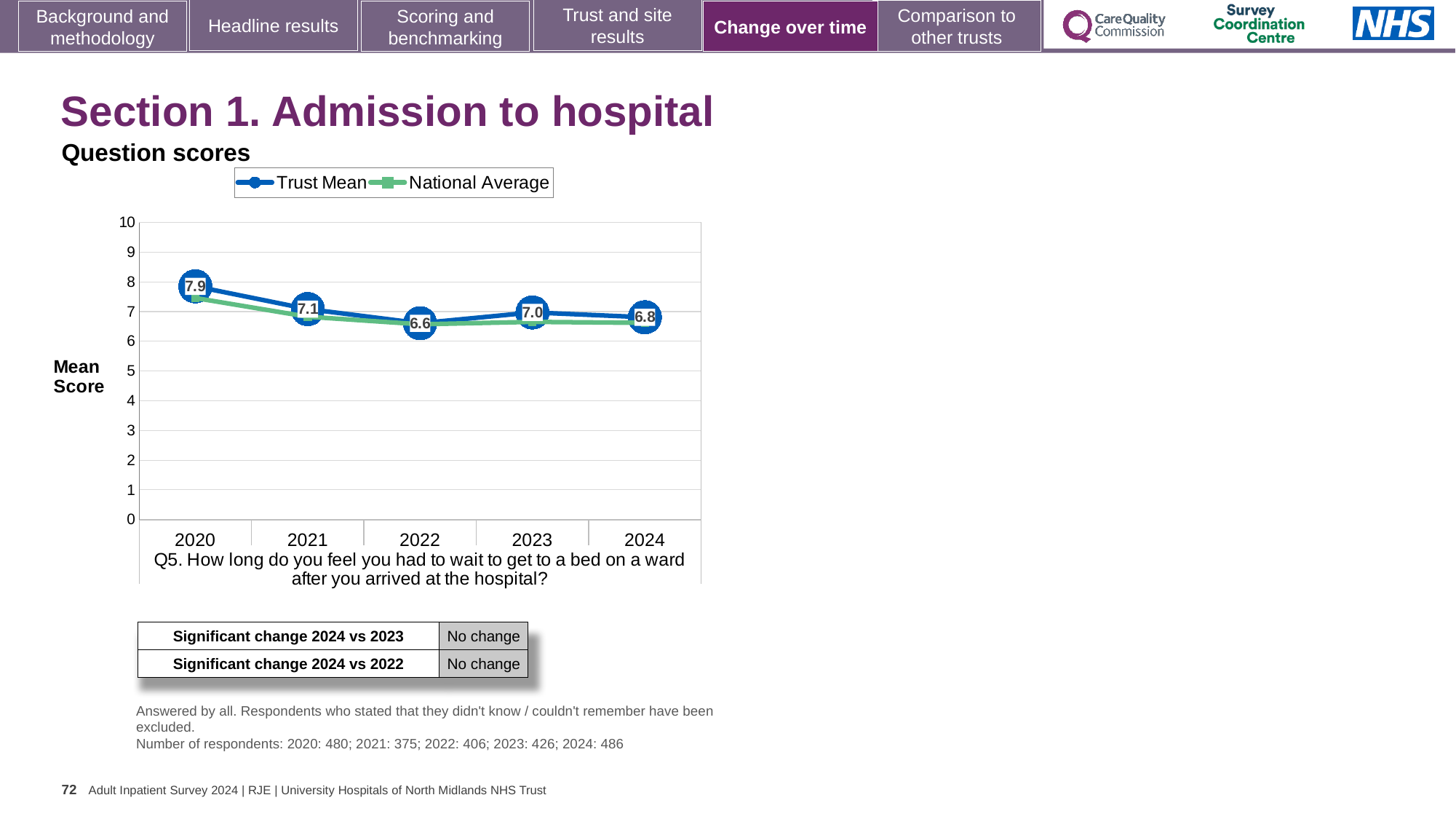
What is the Trust Mean score for 2024? 6.8 In which year is the Trust Mean score highest? 2020 Does the Trust Mean score rise or fall from 2020 to 2022? Fall What is the Trust Mean score for 2022? 6.6 What kind of chart is shown on the slide? Line chart How many series does the legend list? 2 Which year has a higher Trust Mean score, 2023 or 2024? 2023 In which year is the Trust Mean score lowest? 2022 How many years are plotted on the x axis? 5 What is the difference between the Trust Mean score in 2020 and in 2021? 0.8 What is the Trust Mean score for 2020? 7.9 Is the National Average for 2020 greater or less than 7? greater